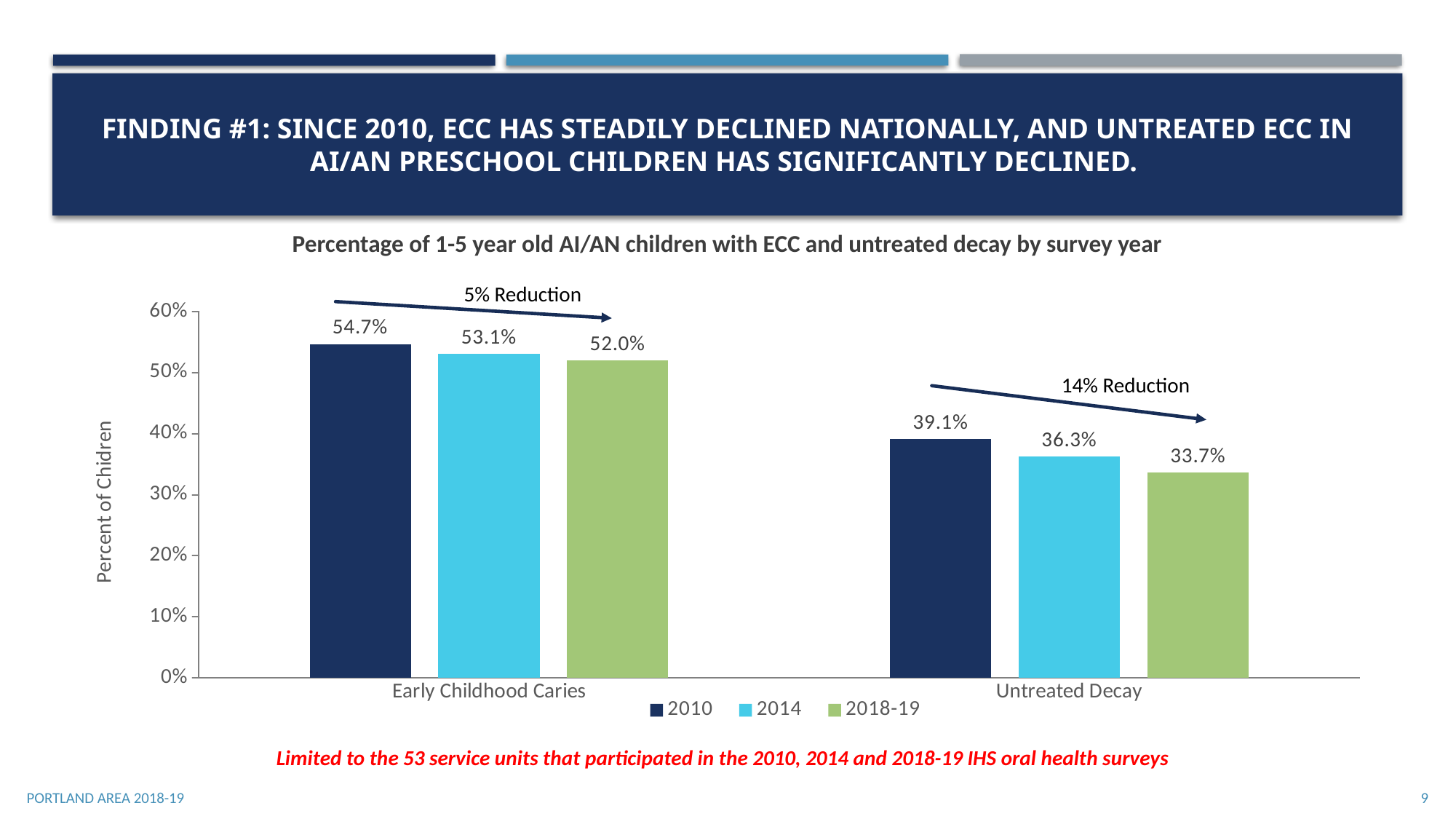
What is the value for Early Childhood Caries in 2014? 53.1% Is the value for Untreated Decay in 2014 greater or less than 40%? less What percentage of children had Early Childhood Caries in 2010? 54.7% What is the value for Untreated Decay in 2018-19? 33.7% What kind of chart is shown on the slide? bar chart Do the values for Early Childhood Caries rise or fall from 2010 to 2018-19? fall Which is larger: Early Childhood Caries in 2018-19 or Untreated Decay in 2010? Early Childhood Caries in 2018-19 How many series does the legend list? 3 What is the difference between the 2010 and 2018-19 values for Untreated Decay? 5.4% What is the title of the chart? Percentage of 1-5 year old AI/AN children with ECC and untreated decay by survey year Which survey year has the highest value for Untreated Decay? 2010 Which survey year has the lowest value for Early Childhood Caries? 2018-19